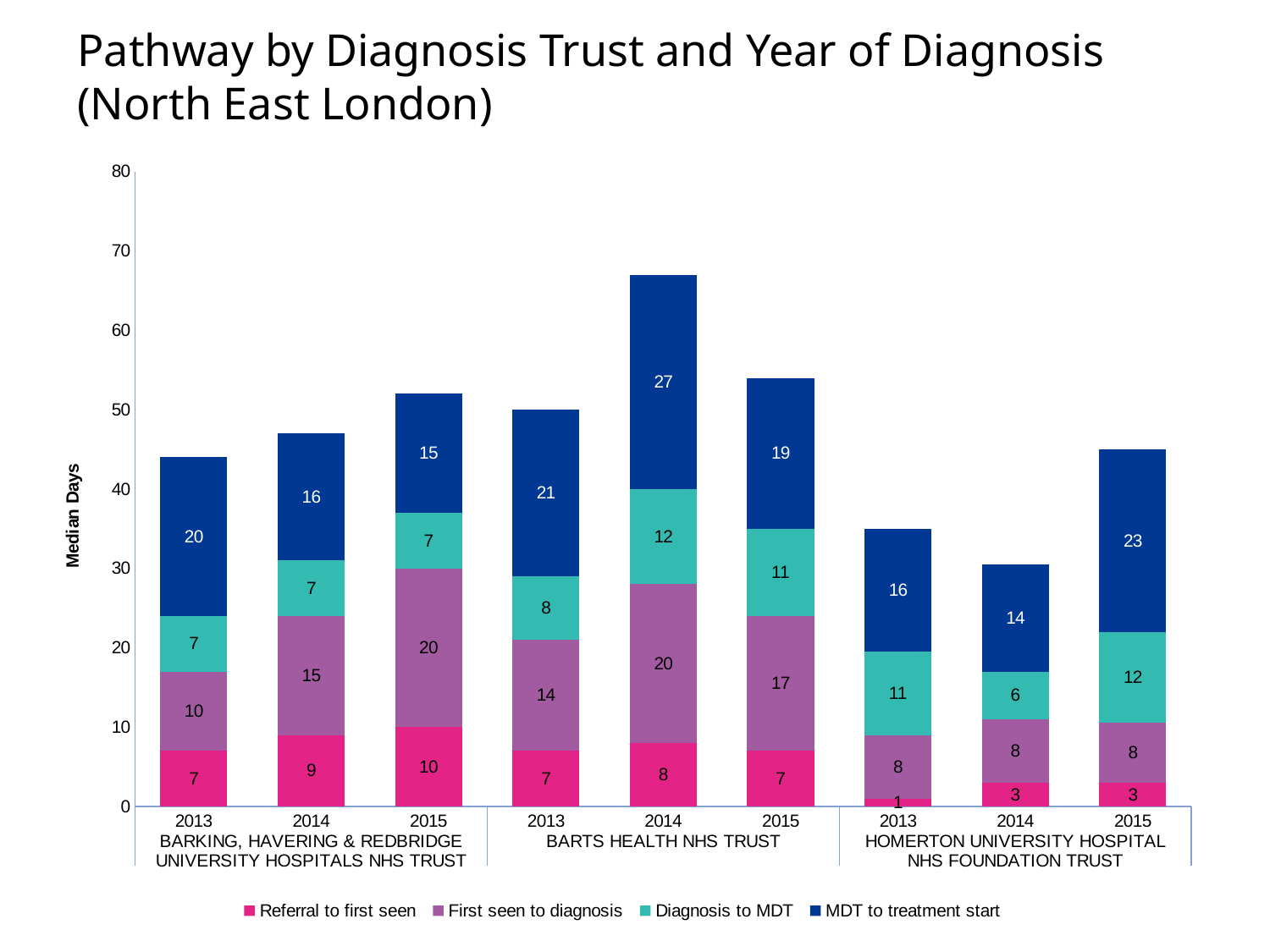
What kind of chart is shown on the slide? Stacked bar chart What is the difference between the MDT to treatment start values for Barts Health NHS Trust in 2014 and 2015? 8 Which trust and year has the highest MDT to treatment start value? Barts Health NHS Trust, 2014 Which trust and year has the lowest Referral to first seen value? Homerton University Hospital NHS Foundation Trust, 2013 What is the total median days for the Barts Health NHS Trust 2014 bar? 67 How many series does the legend list? 4 What is the value for Referral to first seen for Homerton University Hospital NHS Foundation Trust in 2013? 1 How many bars are plotted on the chart? 9 What is the value for MDT to treatment start for Barts Health NHS Trust in 2014? 27 What is the total median days for the Barking, Havering & Redbridge University Hospitals NHS Trust 2013 bar? 44 Which is larger: First seen to diagnosis for Barking, Havering & Redbridge University Hospitals NHS Trust in 2015 or for Barts Health NHS Trust in 2015? Barking, Havering & Redbridge University Hospitals NHS Trust, 2015 Do the total bar heights for Barking, Havering & Redbridge University Hospitals NHS Trust rise or fall from 2013 to 2015? Rise